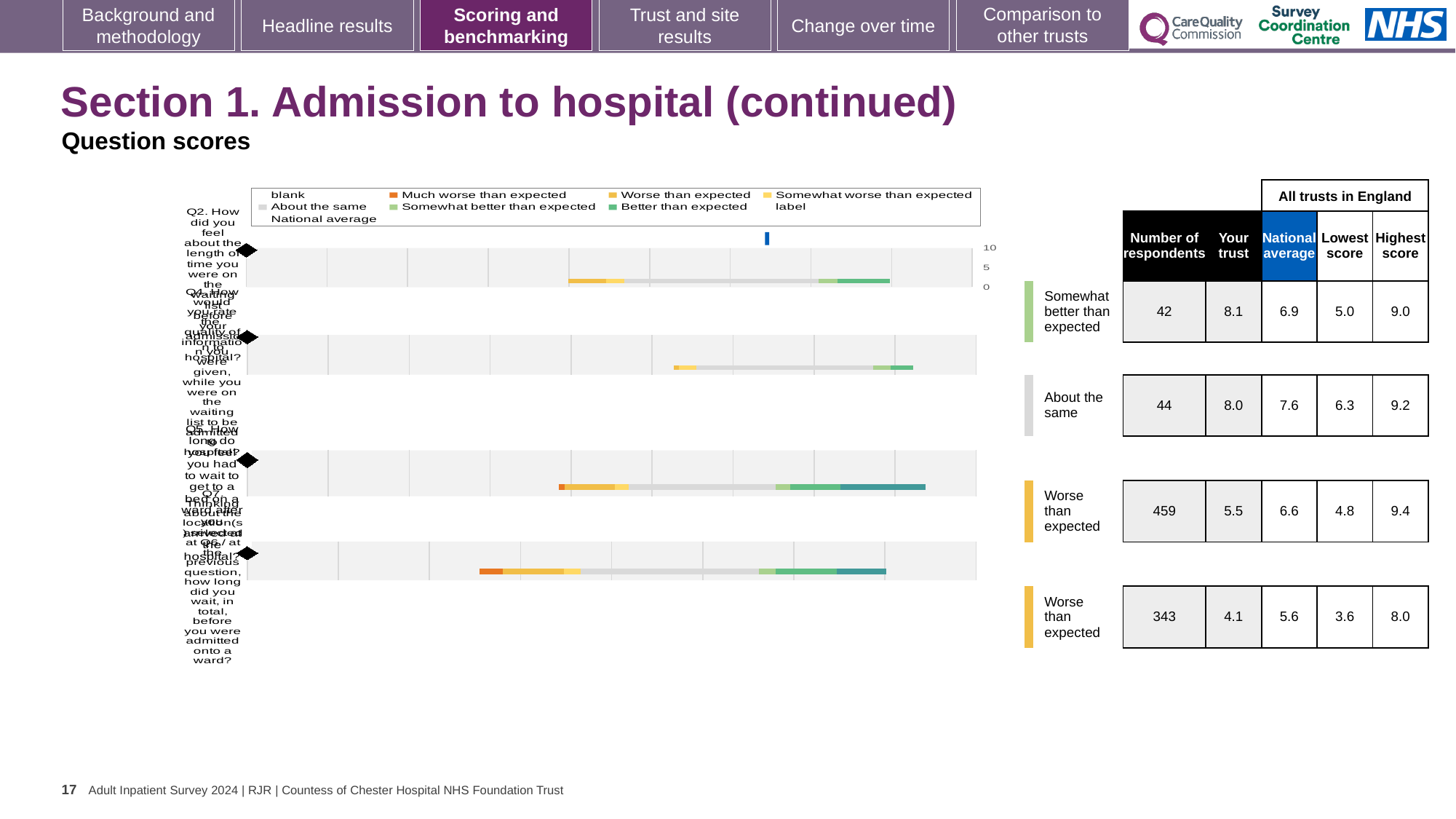
How many question bars are plotted in the chart? 4 In the table, what is the 'Your trust' score for the second row? 8.0 Which row of the table has the lowest 'Your trust' score? The fourth row (4.1) In the table, what is the highest score for the fourth row? 8.0 Which row of the table has the largest number of respondents? The third row (459) In the fourth row of the table, what is the difference between the national average and the 'Your trust' score? 1.5 In the first row of the table, which is larger: the 'Your trust' score or the national average? Your trust What benchmark label is shown next to the second row of the table? About the same What heading appears above the last three columns of the table? All trusts in England In the table, what is the number of respondents for the first row? 42 In the table, what is the national average for the third row? 6.6 What kind of chart is shown on the slide? Bar chart